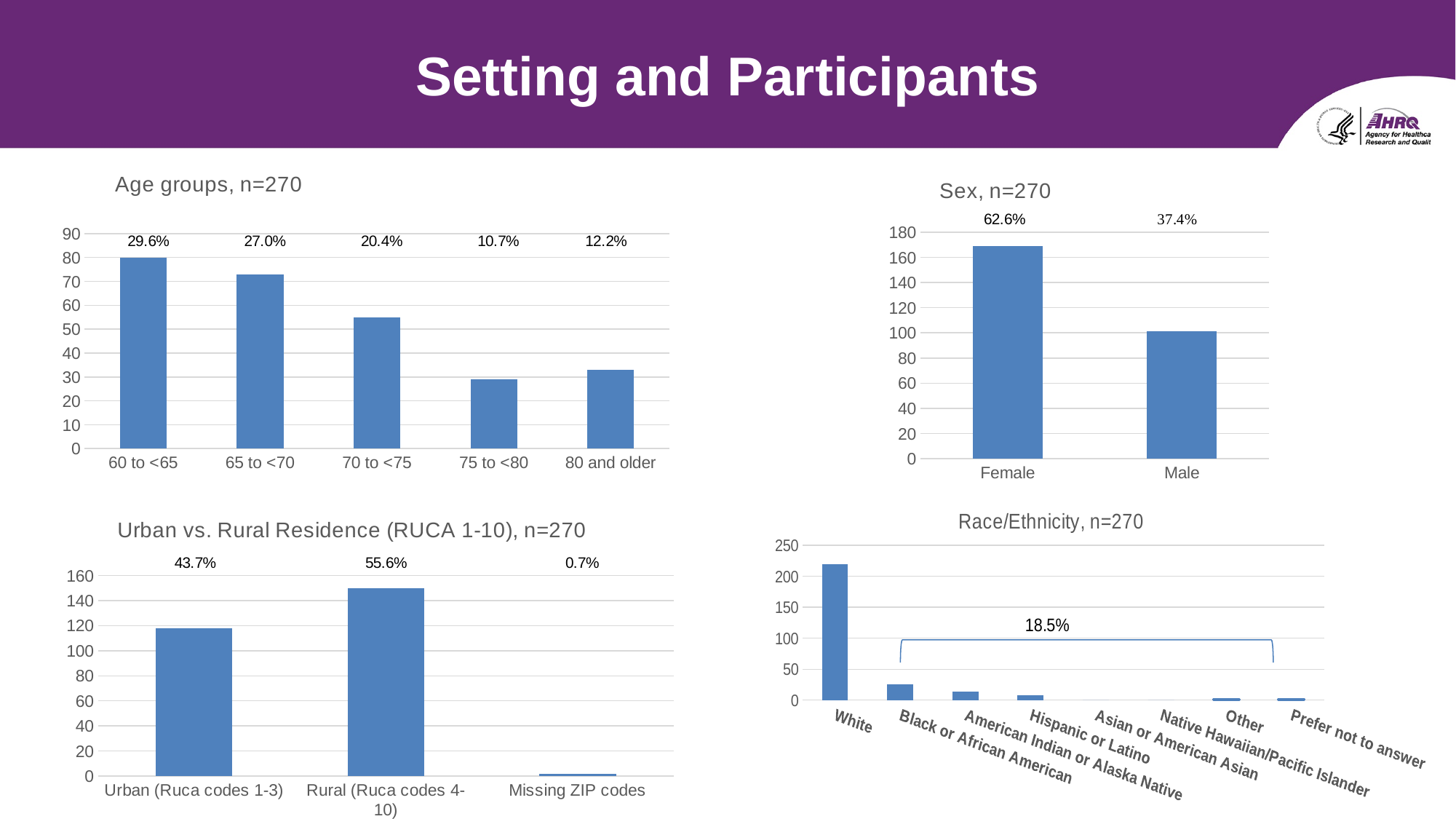
How many age groups are shown in the Age groups chart? 5 In the Sex chart, what percentage label is shown for Female? 62.6% In the Race/Ethnicity chart, which category has the highest bar? White In the Age groups chart, is the value for 70 to <75 greater or less than 50? greater In the Age groups chart, what percentage label is shown for the 60 to <65 group? 29.6% In the Sex chart, what is the difference in percentage points between Female and Male? 25.2 percentage points In the Age groups chart, which age group has the tallest bar? 60 to <65 In the Age groups chart, which age group has the shortest bar? 75 to <80 What kind of chart is the Urban vs. Rural Residence chart? bar chart In the Urban vs. Rural Residence chart, what percentage label is shown for Rural (Ruca codes 4-10)? 55.6% In the Race/Ethnicity chart, is the value for White greater or less than 200? greater In the Sex chart, is the value for Male greater or less than 120? less